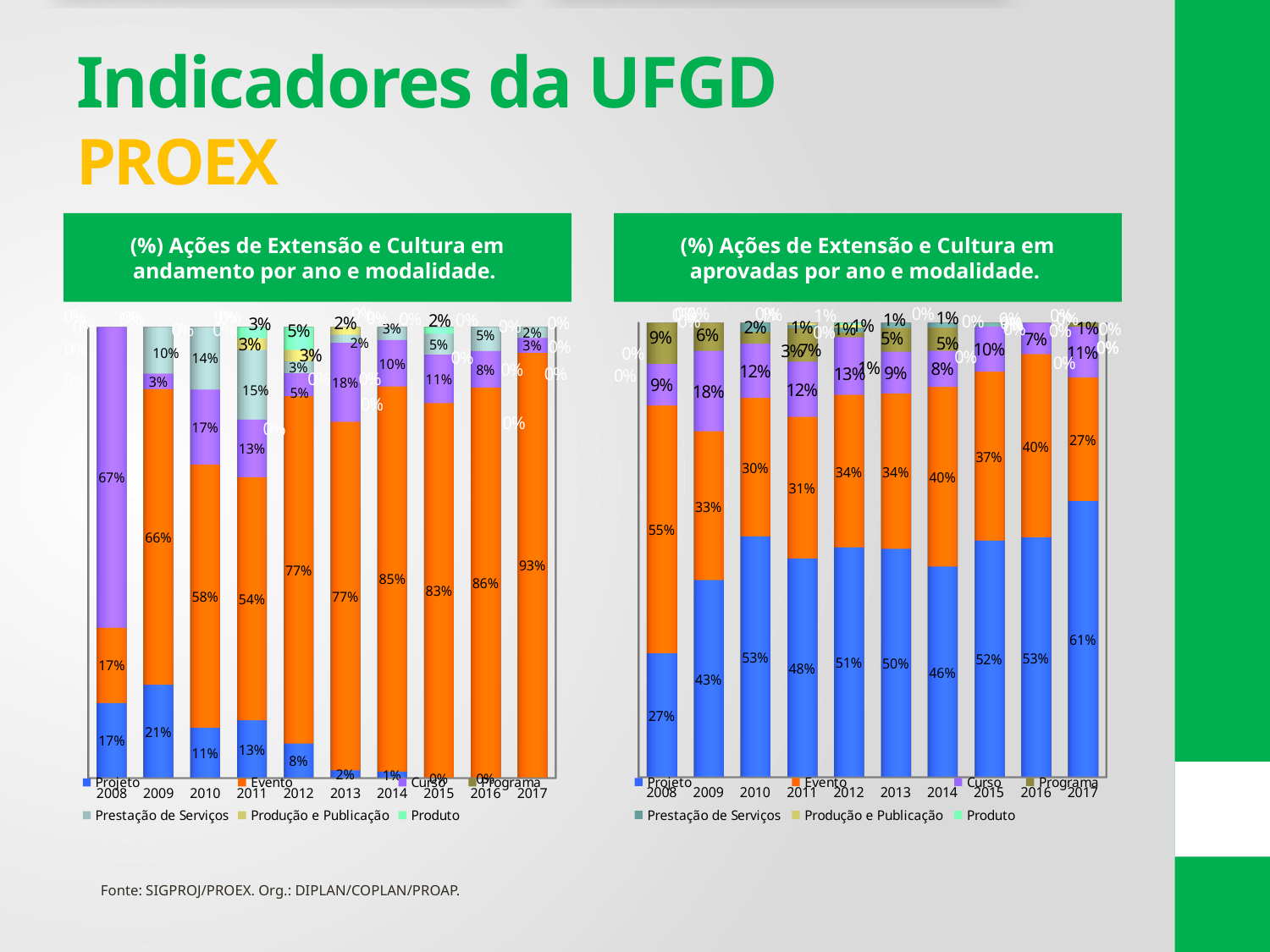
In the right chart (ações aprovadas), which year has the lowest Projeto value? 2008 In the right chart (ações aprovadas), what is the Evento value for 2008? 55% In the left chart (ações em andamento), what is the Evento value for 2017? 93% In the right chart (ações aprovadas), which year has the highest Projeto value? 2017 How many series does the legend of the right chart list? 7 In the right chart (ações aprovadas), what is the Projeto value for 2017? 61% In the left chart (ações em andamento), what is the Curso value for 2008? 67% In the left chart (ações em andamento), what is the difference between the Evento values for 2017 and 2008? 76 percentage points In the left chart (ações em andamento), what is the Projeto value for 2009? 21% How many years are shown on the x axis of the left chart? 10 What type of chart is used on the left side of the slide? Stacked bar chart In the right chart (ações aprovadas), which is larger for 2009: Projeto or Evento? Projeto